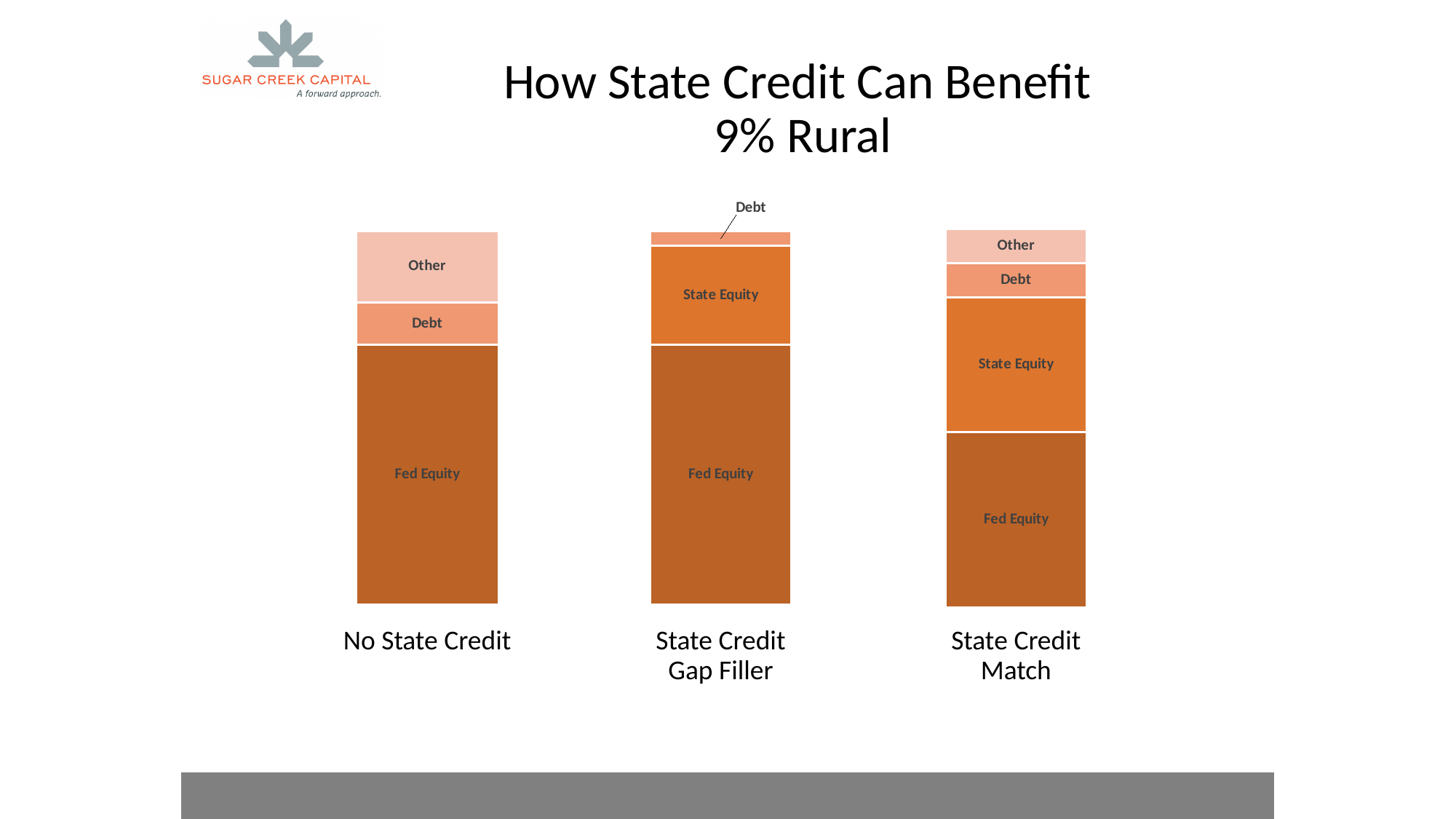
Which segment is the smallest in the State Credit Gap Filler bar? Debt What kind of chart is shown on the slide? Stacked bar chart Is the Debt segment larger in the No State Credit bar or in the State Credit Gap Filler bar? No State Credit Which bar does not include an Other segment? State Credit Gap Filler How many segments make up the State Credit Match bar? 4 Which bar does not include a State Equity segment? No State Credit Which segment is the largest in the State Credit Match bar? Fed Equity Is the State Equity segment larger in the State Credit Gap Filler bar or in the State Credit Match bar? State Credit Match How many bars (categories) are shown in the chart? 3 Which segment is the largest in the No State Credit bar? Fed Equity Is the Fed Equity segment larger in the State Credit Gap Filler bar or in the State Credit Match bar? State Credit Gap Filler